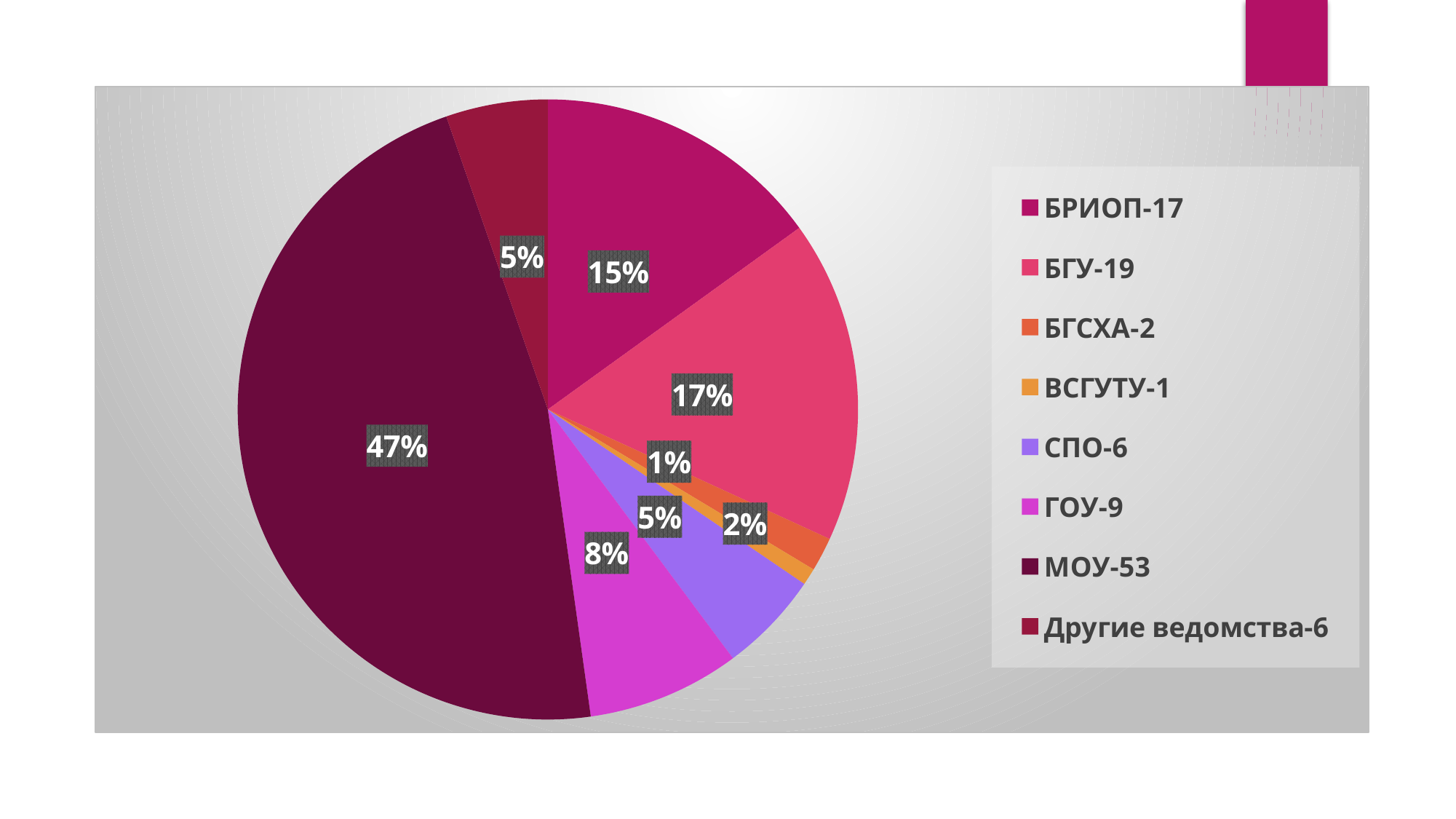
Which has a larger share, ГОУ-9 or СПО-6? ГОУ-9 What percentage share is shown for БГУ-19? 17% What percentage share is shown for ВСГУТУ-1? 1% Which category has the largest slice of the pie? МОУ-53 Which category has the smallest slice of the pie? ВСГУТУ-1 What percentage share is shown for ГОУ-9? 8% How many slices does the pie chart have? 8 How many entries does the legend list? 8 What is the difference in percentage points between the shares of БГУ-19 and БРИОП-17? 2% What kind of chart is shown on the slide? pie chart